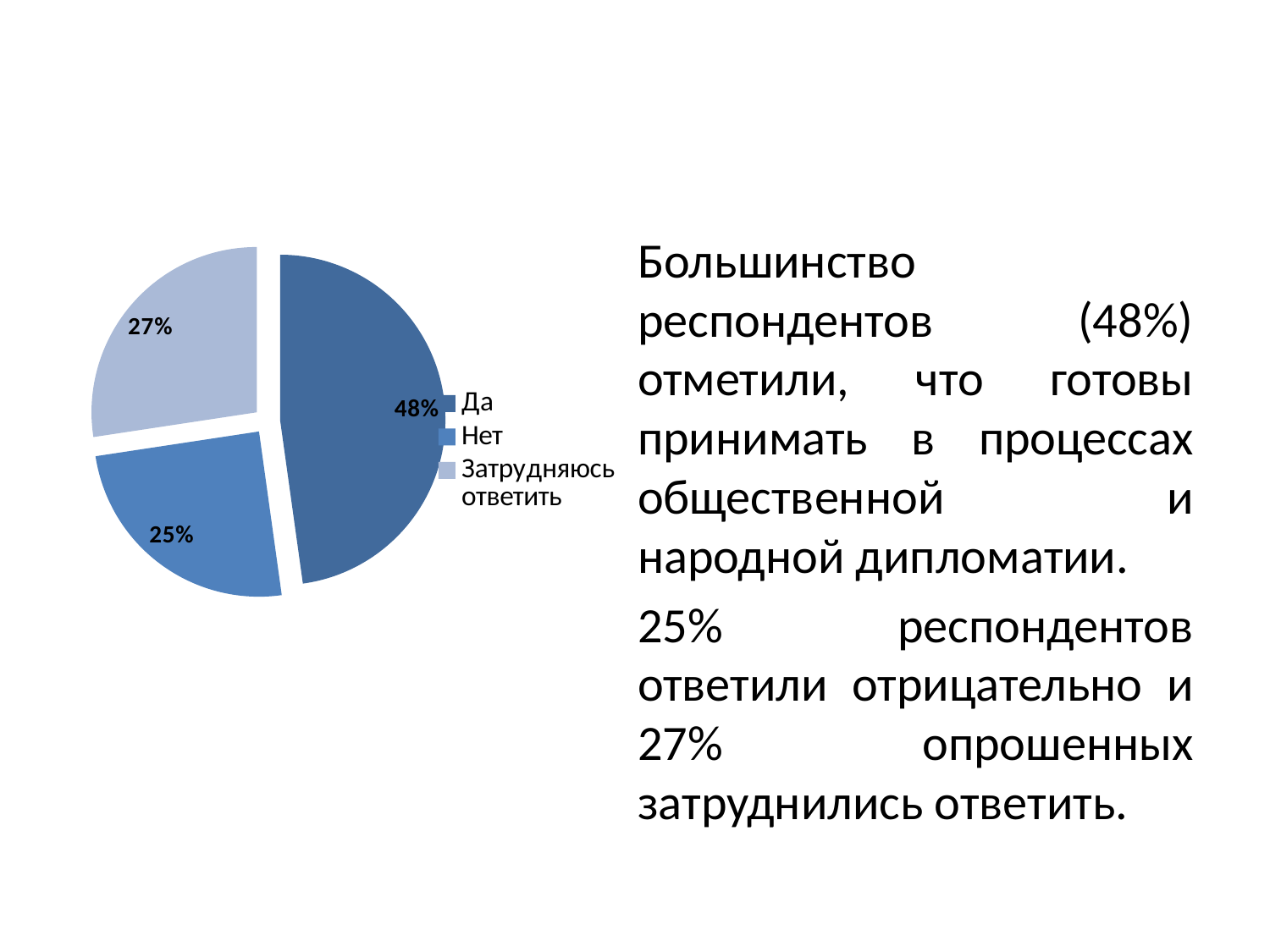
Which category has the largest slice of the pie? Да What share of the pie does the "Да" slice represent? 48% What kind of chart is shown on the slide? Pie chart What is the difference in percentage points between the "Затрудняюсь ответить" slice and the "Нет" slice? 2 How many slices does the pie chart have? 3 How many entries does the legend list? 3 Which category has the smallest slice of the pie? Нет Which is larger, the "Да" slice or the "Затрудняюсь ответить" slice? Да What is the difference in percentage points between the "Да" slice and the "Нет" slice? 23 What share of the pie does the "Нет" slice represent? 25% Which legend entry is shown with the lightest blue colour? Затрудняюсь ответить What share of the pie does the "Затрудняюсь ответить" slice represent? 27%